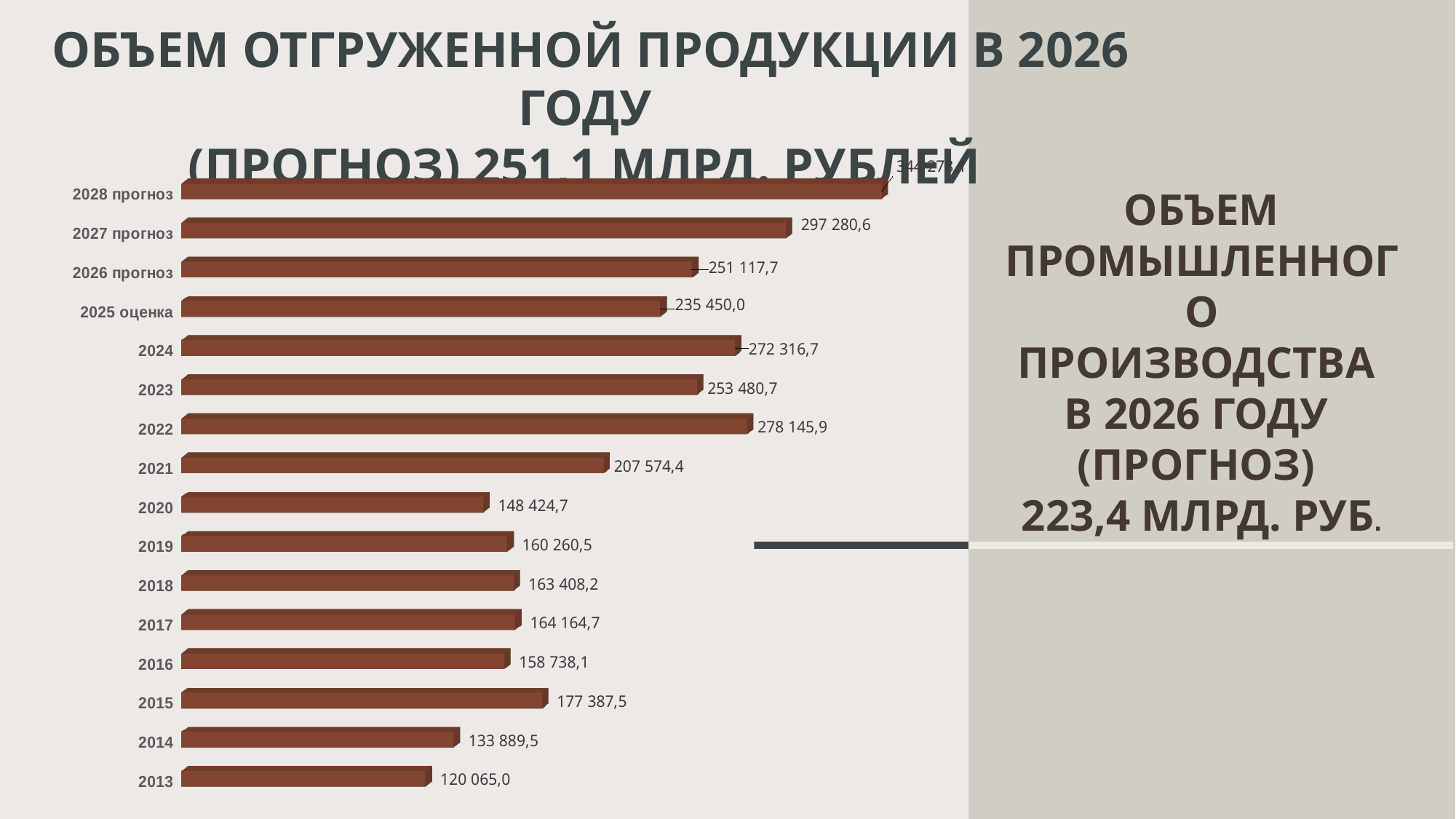
What is the difference between the values for 2014 and 2013? 13 824,5 What is the value for 2020? 148 424,7 How many categories are shown in the chart? 16 What kind of chart is shown on the slide? Bar chart Which is larger, the value for 2024 or the value for 2023? 2024 What is the value for 2013? 120 065,0 Do the values rise or fall from 2025 оценка to 2028 прогноз? Rise Which category has the lowest value? 2013 What is the difference between the values for 2022 and 2021? 70 571,5 What is the value for 2025 оценка? 235 450,0 What is the value for 2026 прогноз? 251 117,7 Which category has the highest value? 2028 прогноз